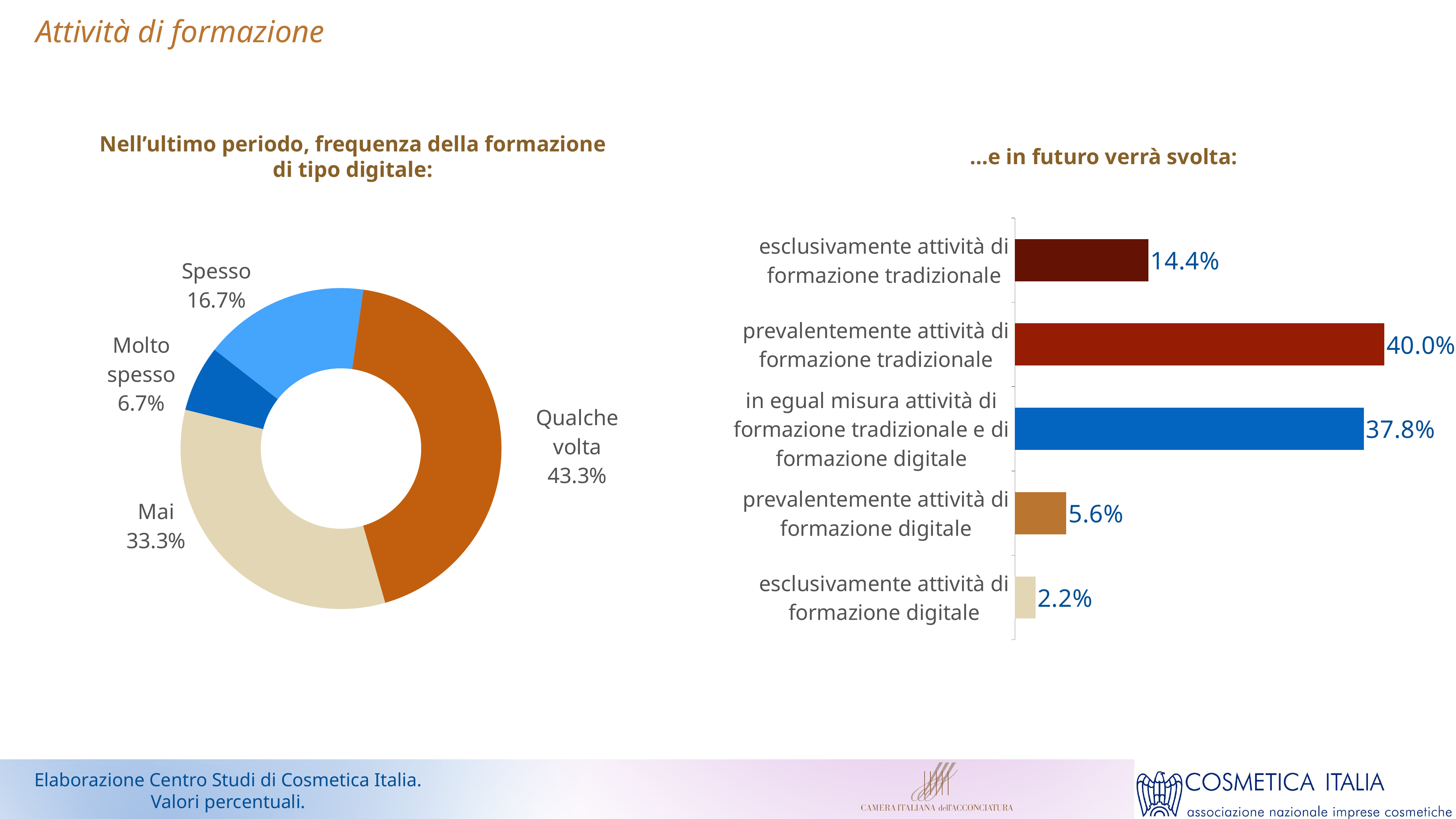
What kind of chart is the right chart ('...e in futuro verrà svolta')? Bar chart In the left chart (frequency of digital training), how many categories are shown? 4 In the right chart ('...e in futuro verrà svolta'), what is the value for 'prevalentemente attività di formazione tradizionale'? 40.0% What kind of chart is the left chart (frequency of digital training)? Doughnut chart In the right chart ('...e in futuro verrà svolta'), what is the value for 'esclusivamente attività di formazione digitale'? 2.2% In the left chart (frequency of digital training), what is the difference between the shares for 'Mai' and 'Spesso'? 16.6% In the left chart (frequency of digital training), what share is labelled for 'Molto spesso'? 6.7% In the right chart ('...e in futuro verrà svolta'), which category has the lowest value? esclusivamente attività di formazione digitale In the right chart ('...e in futuro verrà svolta'), what is the difference between 'esclusivamente attività di formazione tradizionale' and 'prevalentemente attività di formazione digitale'? 8.8% In the left chart (frequency of digital training), what share is labelled for 'Qualche volta'? 43.3% In the left chart (frequency of digital training), which category has the largest share? Qualche volta In the left chart (frequency of digital training), which category has the smallest share? Molto spesso